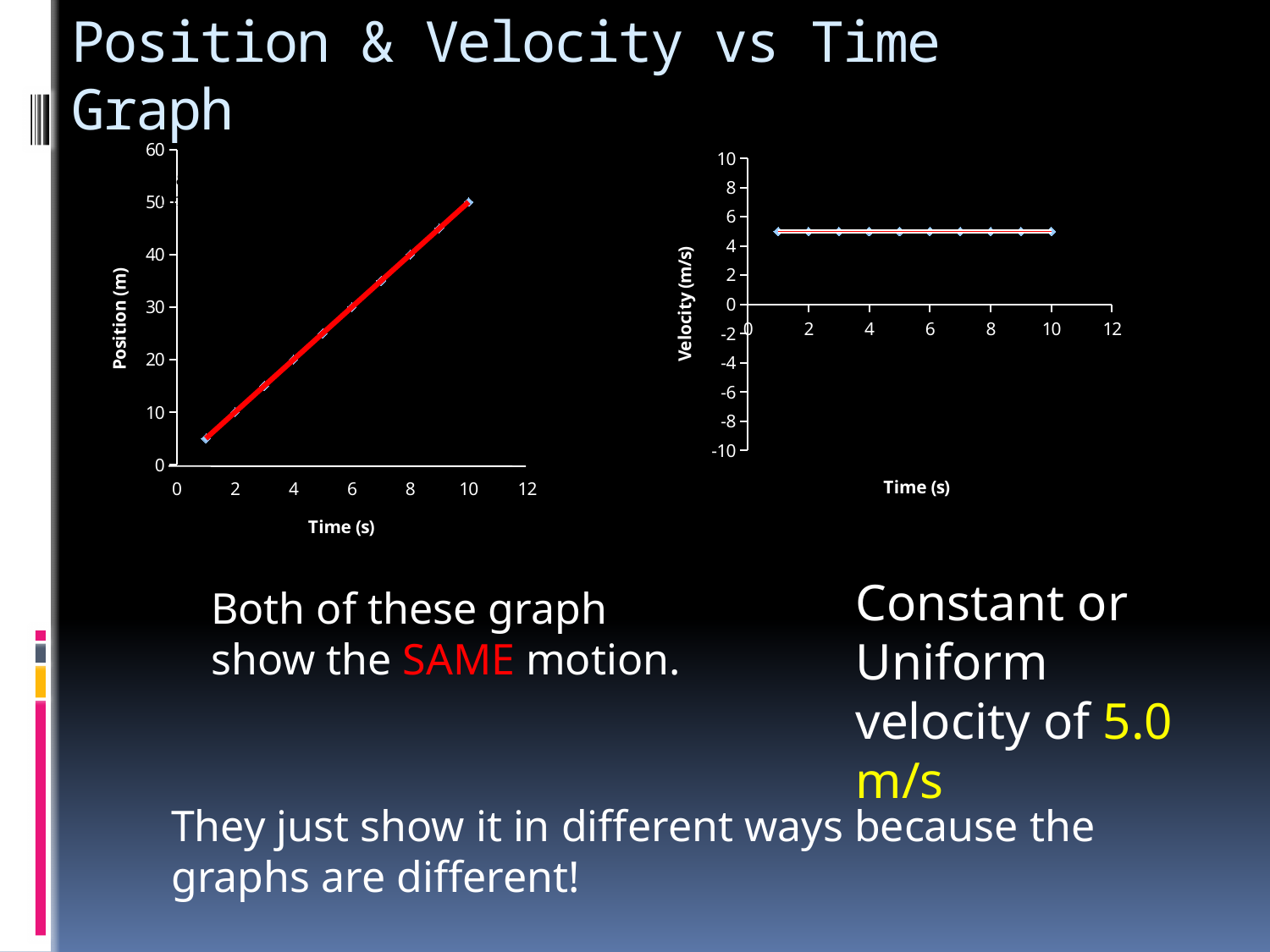
On the Position vs Time chart (left), what is the position at time 10 s? 50 On the Velocity vs Time chart (right), how many data points are plotted? 10 On the Position vs Time chart (left), is the position at time 3 s greater or less than 20? less On the Position vs Time chart (left), do the values rise or fall as time increases? rise On the Position vs Time chart (left), at which time is the position highest? 10 s On the Position vs Time chart (left), is the position at time 5 s greater or less than 20? greater What is the y-axis label of the chart on the right? Velocity (m/s) On the Velocity vs Time chart (right), do the values rise, fall or stay constant as time increases? stay constant On the Position vs Time chart (left), which is larger: the position at 8 s or at 4 s? 8 s On the Velocity vs Time chart (right), is the velocity at time 4 s greater or less than 4? greater On the Position vs Time chart (left), what is the position at time 2 s? 10